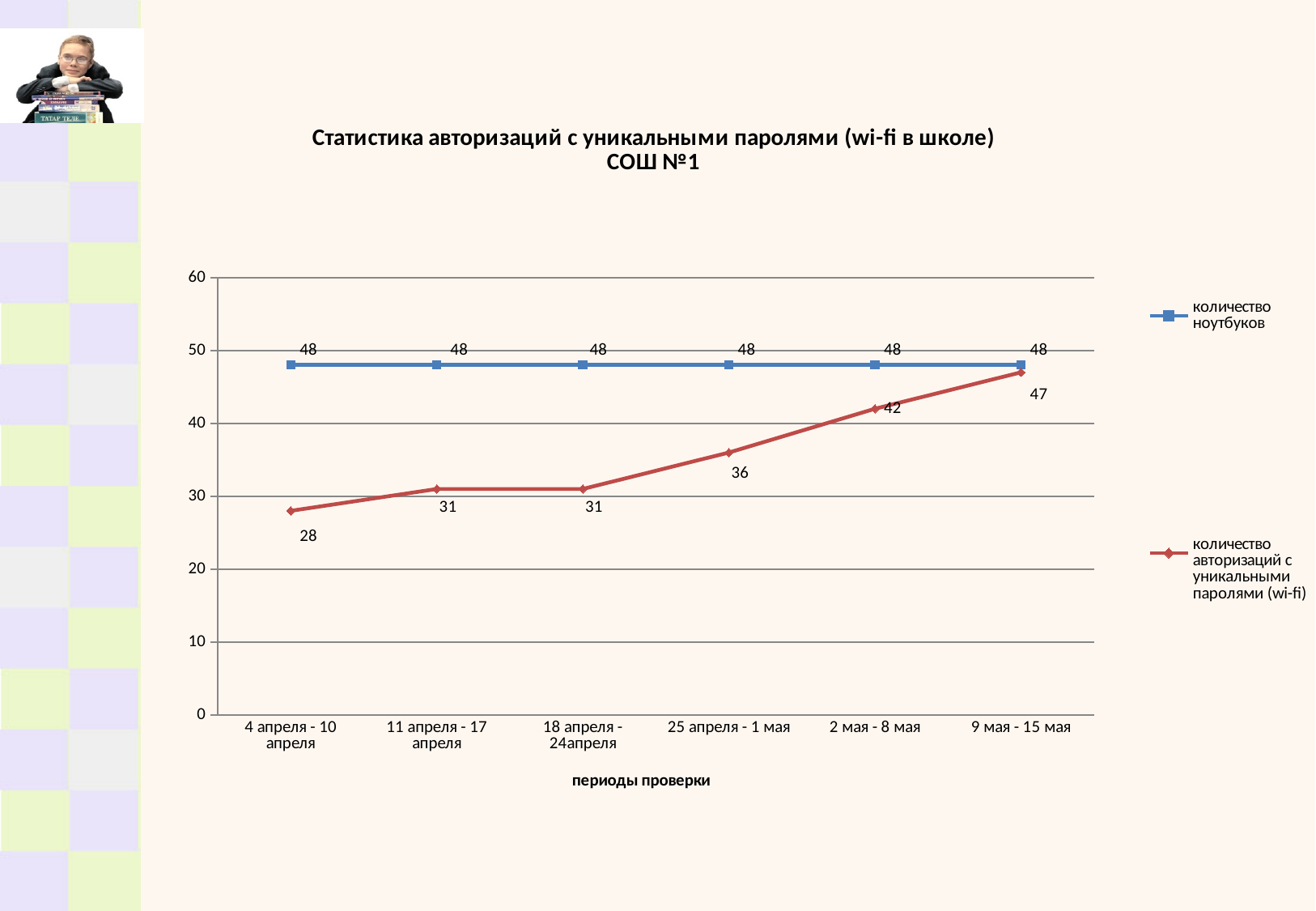
What is the value of 'количество авторизаций с уникальными паролями (wi-fi)' for the period '4 апреля - 10 апреля'? 28 What kind of chart is shown on the slide? line chart In which period is the value of 'количество авторизаций с уникальными паролями (wi-fi)' highest? 9 мая - 15 мая What is the value of 'количество ноутбуков' for the period '2 мая - 8 мая'? 48 What is the difference between the authorizations value for '2 мая - 8 мая' and for '25 апреля - 1 мая'? 6 How many series does the legend list? 2 What is the difference between 'количество ноутбуков' and 'количество авторизаций с уникальными паролями (wi-fi)' in the period '9 мая - 15 мая'? 1 In which period is the value of 'количество авторизаций с уникальными паролями (wi-fi)' lowest? 4 апреля - 10 апреля Does the 'количество авторизаций с уникальными паролями (wi-fi)' series generally rise or fall across the periods? rise How many periods are shown on the x axis? 6 What is the value of 'количество авторизаций с уникальными паролями (wi-fi)' for the period '25 апреля - 1 мая'? 36 What is the title of the chart? Статистика авторизаций с уникальными паролями (wi-fi в школе) СОШ №1